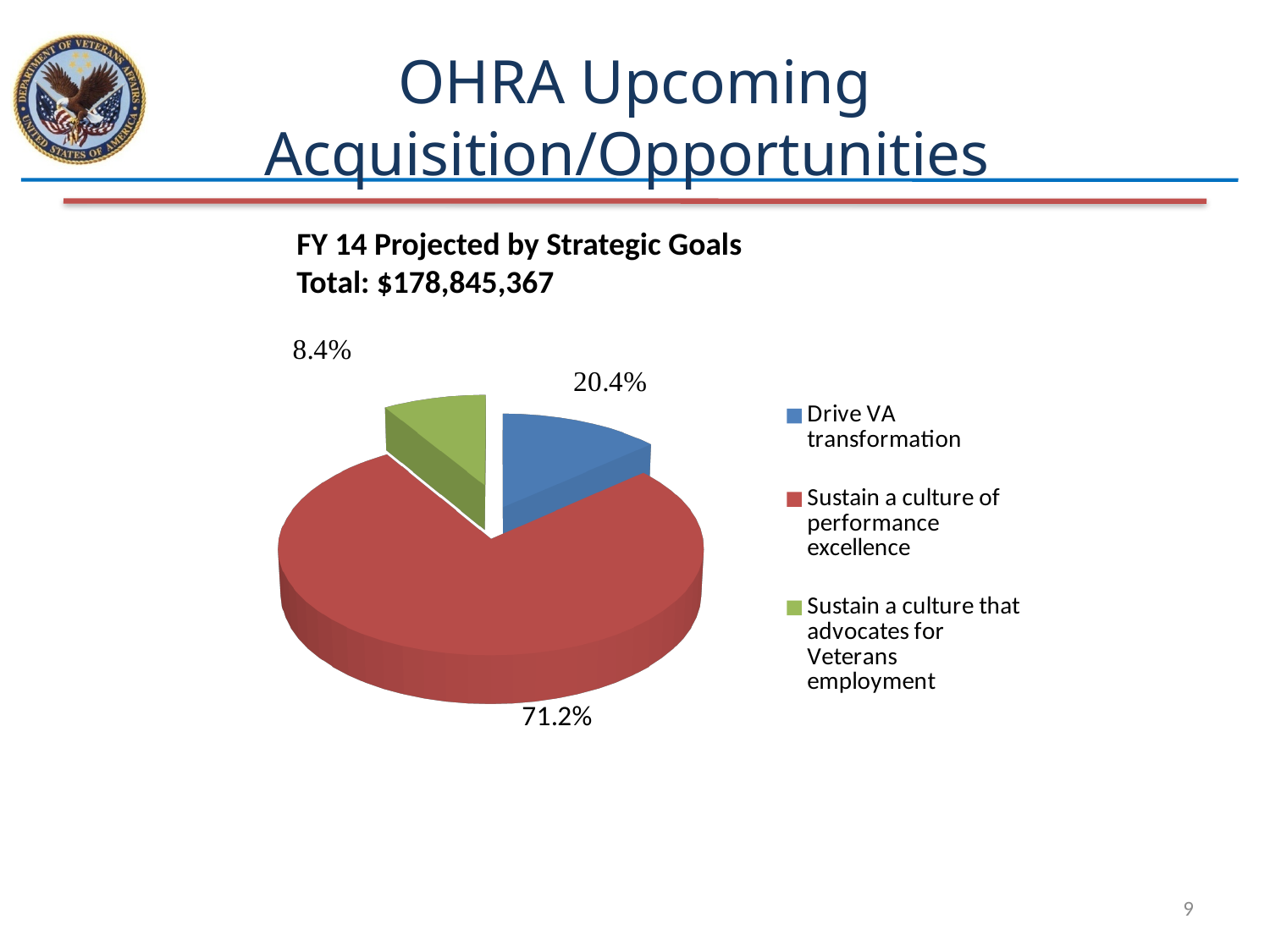
What is the difference in percentage points between the "Sustain a culture of performance excellence" slice and the "Drive VA transformation" slice? 50.8 percentage points Which slice is larger: "Drive VA transformation" or "Sustain a culture that advocates for Veterans employment"? Drive VA transformation How many entries does the legend list? 3 What share of the pie does "Drive VA transformation" represent? 20.4% What share of the pie does "Sustain a culture of performance excellence" represent? 71.2% What kind of chart is shown on the slide? Pie chart How many slices does the pie chart have? 3 What is the title of the chart? FY 14 Projected by Strategic Goals Total: $178,845,367 Which strategic goal has the smallest share of the pie? Sustain a culture that advocates for Veterans employment What share of the pie does "Sustain a culture that advocates for Veterans employment" represent? 8.4% Which strategic goal has the largest share of the pie? Sustain a culture of performance excellence What colour is the slice for "Sustain a culture of performance excellence"? Red